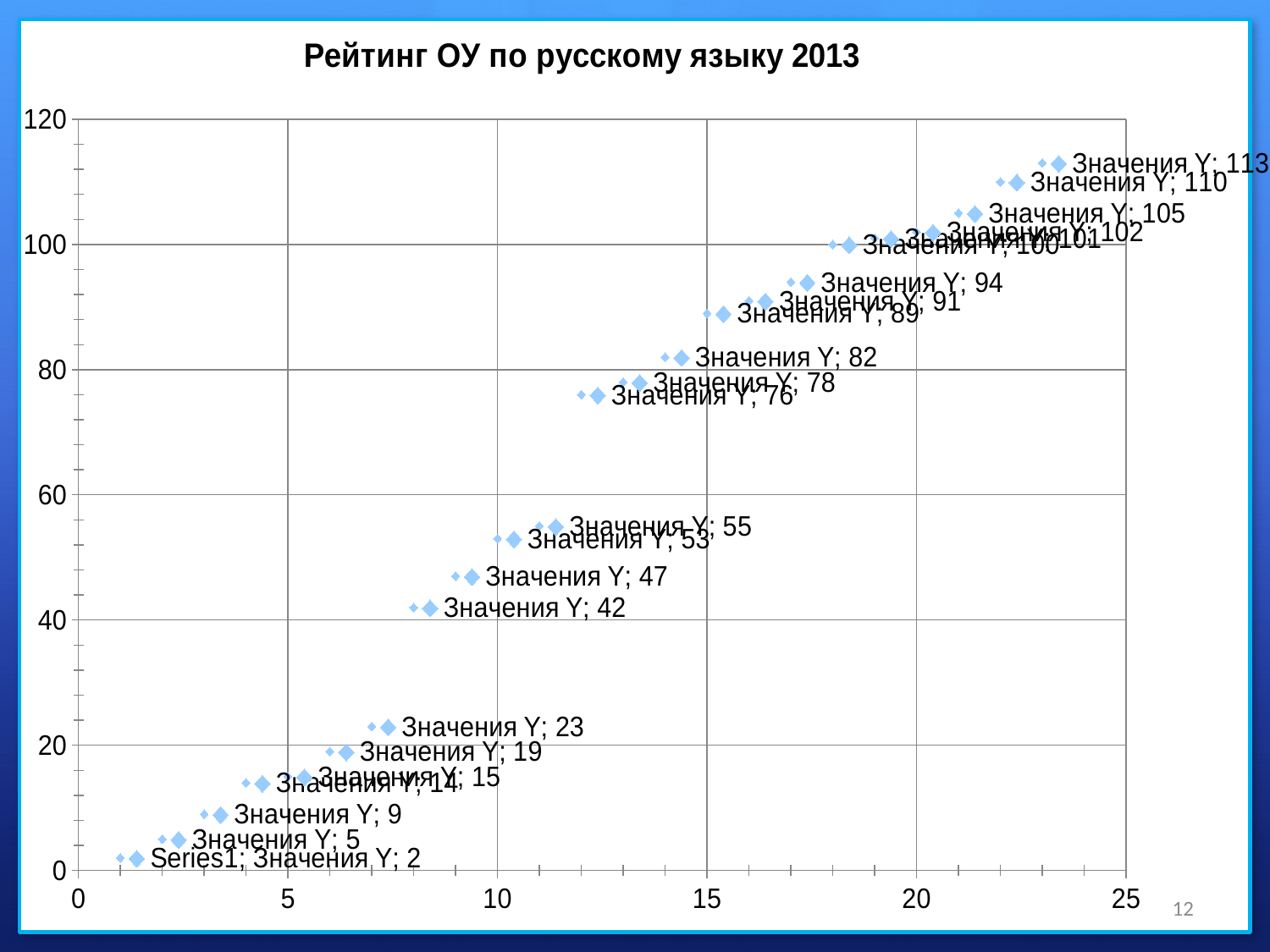
Is the Y value of the point at x = 15 greater or less than 80? greater What is the maximum value shown on the vertical axis? 120 What is the highest Y value labelled on the chart? 113 Do the Y values rise or fall as you move from left to right along the x axis? rise What is the lowest Y value labelled on the chart? 2 What is the difference between the highest labelled Y value (113) and the lowest labelled Y value (2)? 111 What Y value is labelled for the point just above the 40 gridline, at about x = 8? 42 Is the Y value of the point at x = 10 greater or less than 60? less Which is larger: the point labelled 'Значения Y; 82' or the point labelled 'Значения Y; 78'? Значения Y; 82 What is the title of the chart? Рейтинг ОУ по русскому языку 2013 What is the difference between the labelled Y values 110 and 105? 5 What type of chart is shown on the slide? scatter chart